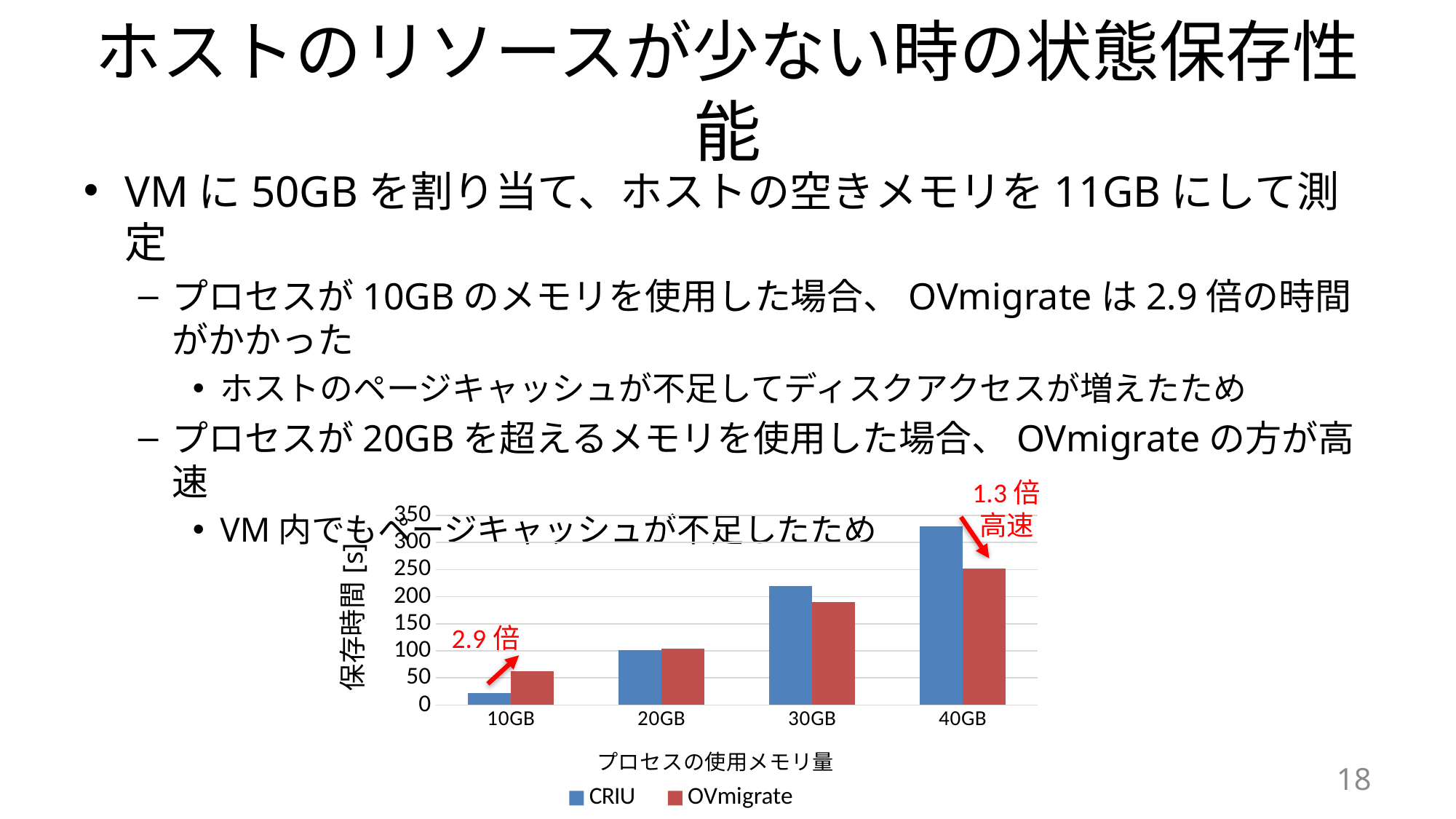
At 40GB, which series has the larger value, CRIU or OVmigrate? CRIU Which series is drawn in blue in the chart? CRIU What kind of chart is shown on the slide? bar chart How many categories are shown on the x axis of the chart? 4 Do the CRIU values rise or fall as the process memory increases from 10GB to 40GB? rise For which category is the CRIU bar the lowest? 10GB What is the label of the y axis of the chart? 保存時間 [s] For which category is the CRIU bar the highest? 40GB How many series does the chart legend list? 2 Is the value for OVmigrate at 30GB greater or less than 200? less At 10GB, which series has the larger value, CRIU or OVmigrate? OVmigrate Is the value for CRIU at 40GB greater or less than 300? greater